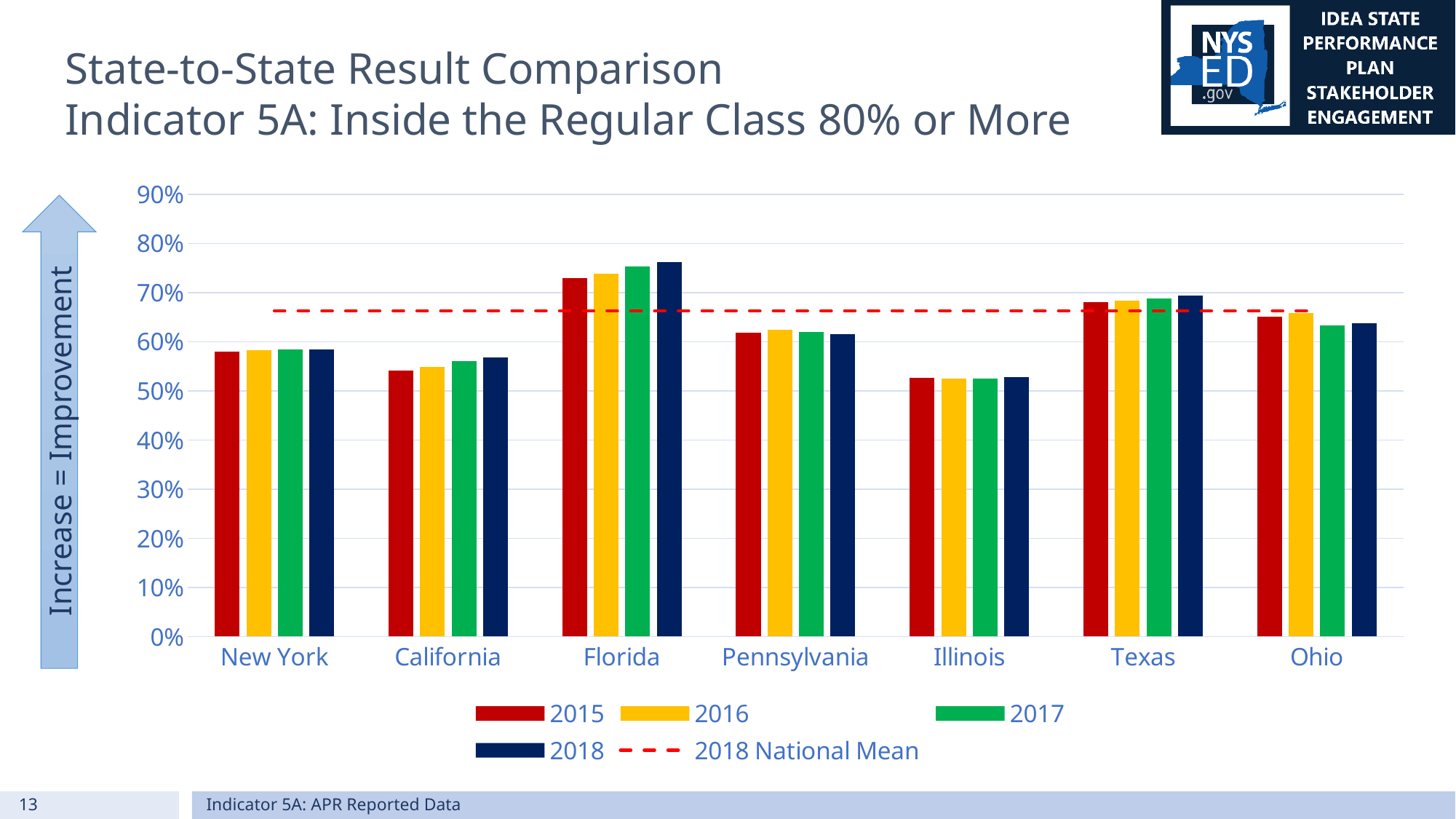
Which state has the highest values in the chart? Florida What kind of chart is shown on the slide? bar chart Is the 2015 value for Illinois greater or less than 60%? less Which is larger, the 2018 value for Texas or the 2018 value for Ohio? Texas How many entries does the chart's legend list? 5 Is the 2018 value for New York greater or less than 60%? less What does the red dashed line in the chart represent? 2018 National Mean Is the 2018 value for Florida greater or less than 70%? greater Which state has the lowest values in the chart? Illinois How many states are shown on the x axis of the chart? 7 Do the values for California rise or fall from 2015 to 2018? rise